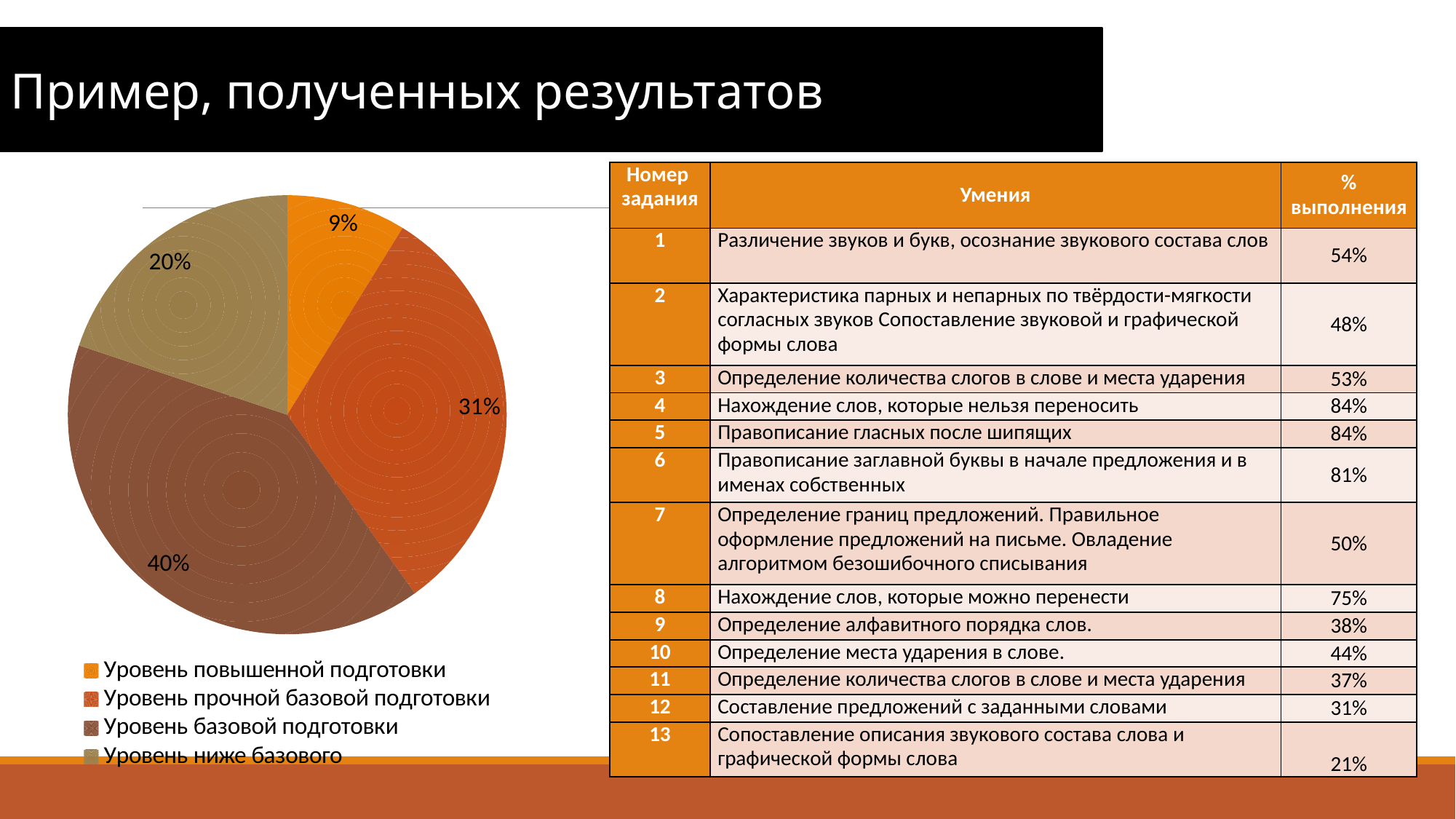
What share of the pie does "Уровень прочной базовой подготовки" have? 31% Which category has the largest slice of the pie chart? Уровень базовой подготовки What kind of chart is shown on the slide? pie chart How many slices does the pie chart have? 4 Which is larger in the pie chart: "Уровень прочной базовой подготовки" or "Уровень ниже базового"? Уровень прочной базовой подготовки Which category has the smallest slice of the pie chart? Уровень повышенной подготовки What share of the pie does "Уровень повышенной подготовки" have? 9% What share of the pie does "Уровень ниже базового" have? 20% Which legend entry is shown in the lightest orange colour in the pie chart? Уровень повышенной подготовки What is the difference in percentage points between "Уровень базовой подготовки" and "Уровень ниже базового"? 20% How many entries does the pie chart's legend list? 4